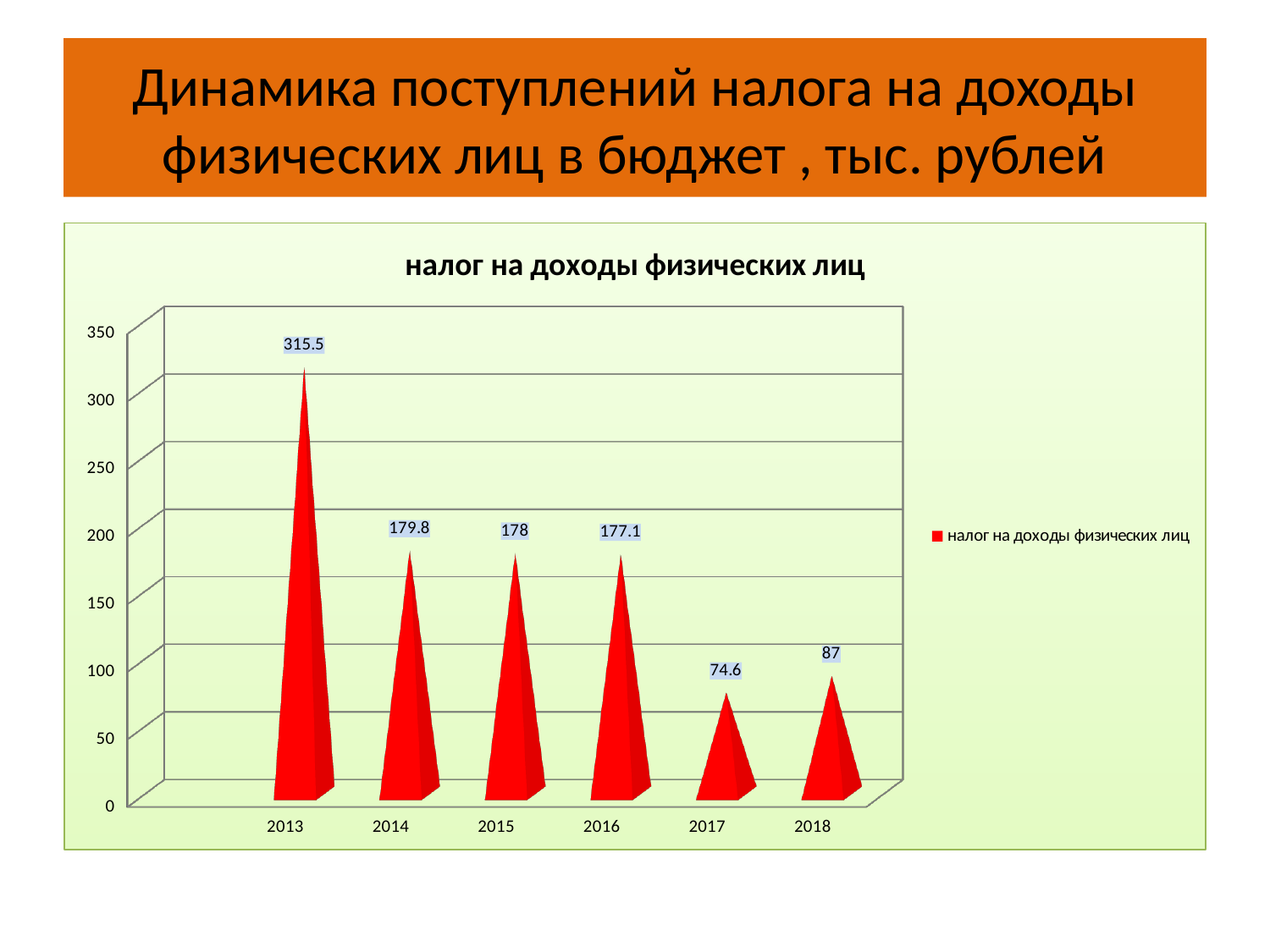
How many years are shown on the x axis? 6 Which year has the lowest value? 2017 What is the value for 2015? 178 What is the value for 2013? 315.5 Which year has the highest value? 2013 What is the title of the chart? налог на доходы физических лиц How many series does the legend list? 1 What is the difference between the values for 2018 and 2017? 12.4 What is the value for 2018? 87 What is the difference between the values for 2013 and 2014? 135.7 Which is larger, the value for 2017 or the value for 2018? 2018 What is the value for 2017? 74.6